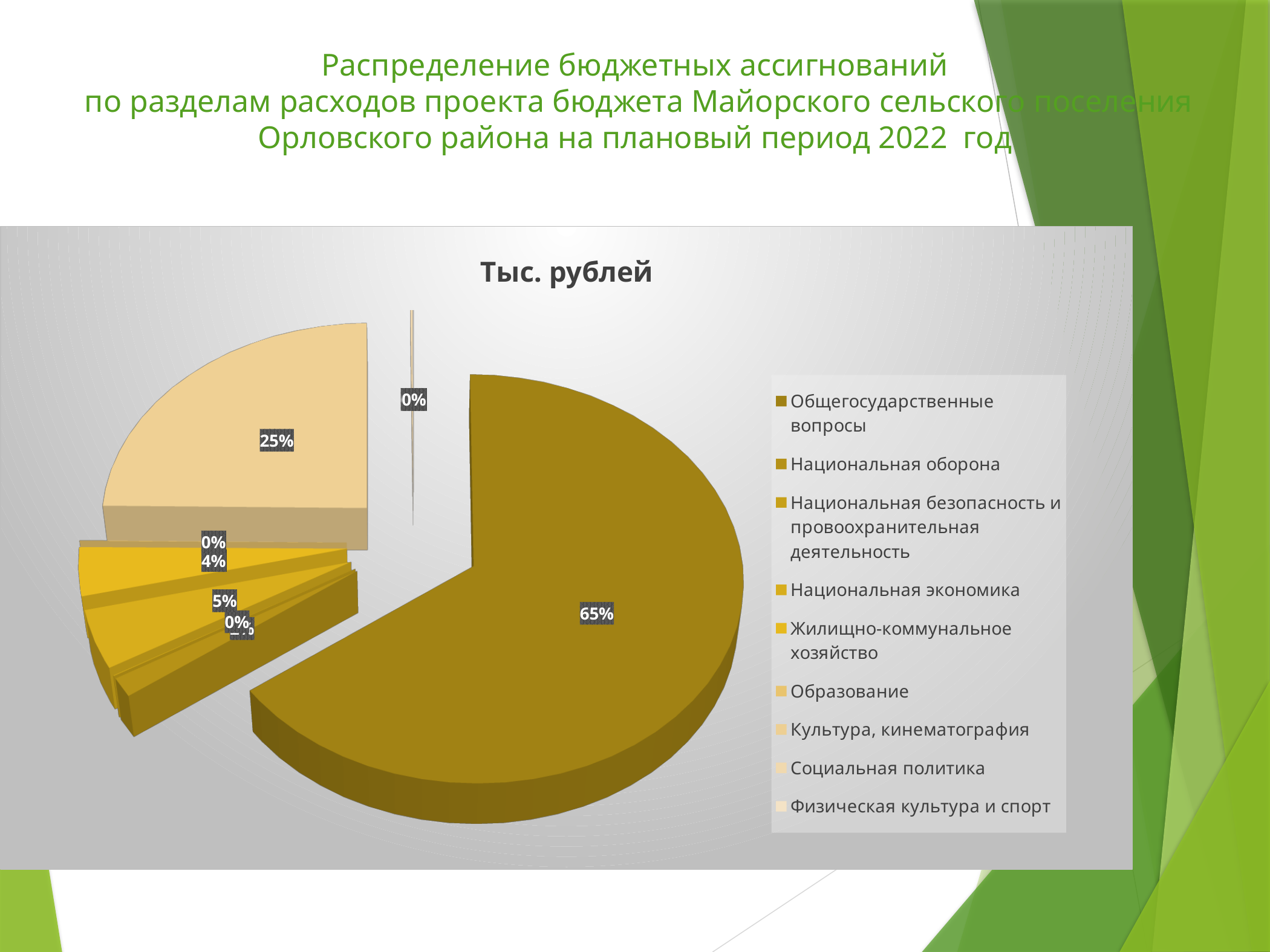
What is the combined share of the two largest slices (65% and 25%)? 90% What is the last entry listed in the legend? Физическая культура и спорт Is the share for Общегосударственные вопросы greater or less than 50%? greater How many entries does the chart legend list? 9 Which is larger, the slice labelled 5% or the slice labelled 4%? the slice labelled 5% What is the share of the second-largest slice of the pie? 25% What is the difference between the largest slice (65%) and the second-largest slice (25%)? 40 percentage points What kind of chart is shown on the slide? pie chart Which category has the largest share of the pie? Общегосударственные вопросы What is the chart's title? Тыс. рублей What is the share of the largest slice of the pie? 65%